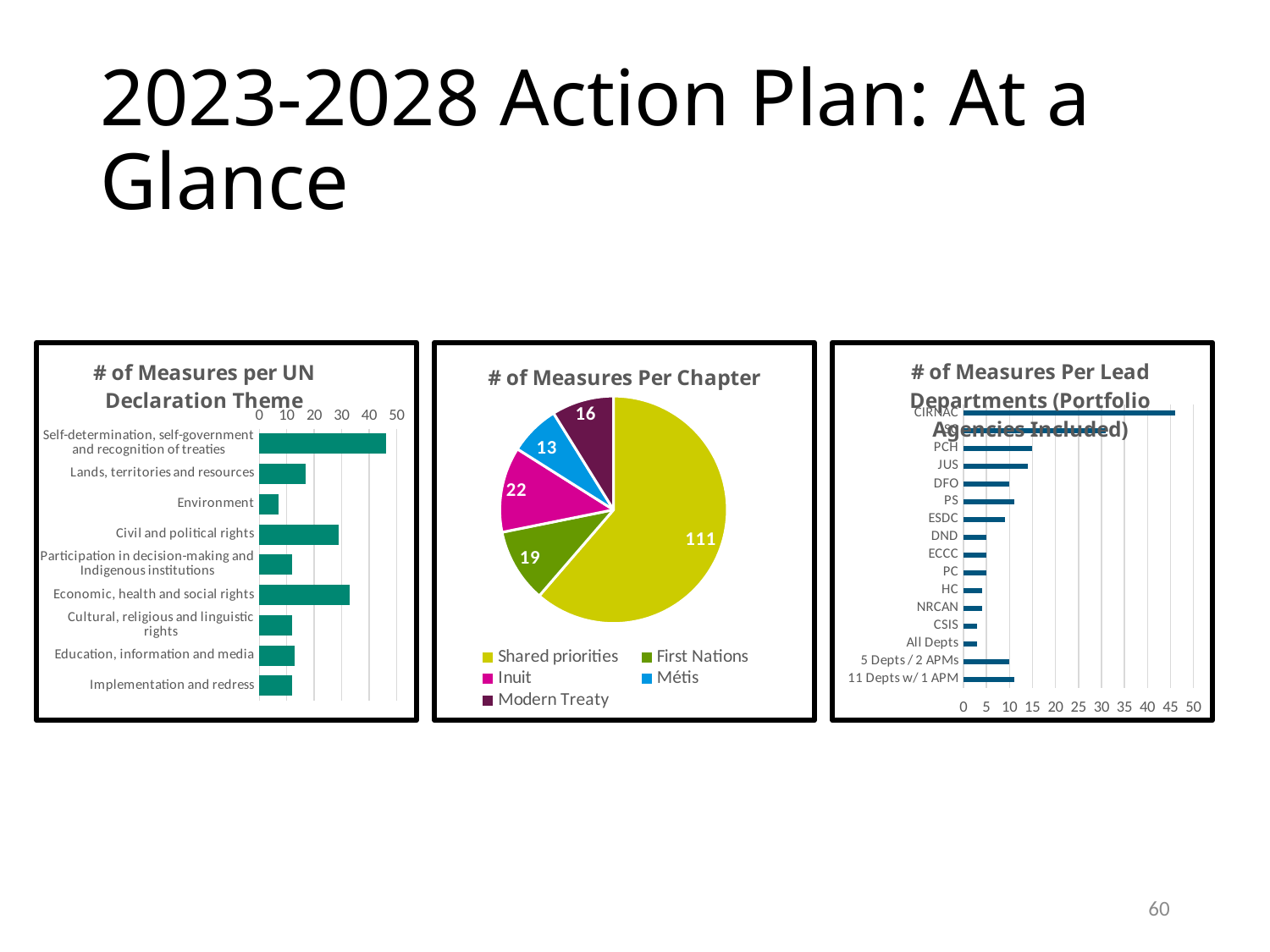
In the '# of Measures Per Chapter' chart, what is the difference between the Inuit and First Nations values? 3 In the '# of Measures Per Lead Departments' chart, which department has the most measures? CIRNAC What kind of chart is the '# of Measures Per Lead Departments (Portfolio Agencies Included)' chart? Bar chart In the '# of Measures Per Chapter' chart, which is larger, Modern Treaty or Métis? Modern Treaty In the '# of Measures per UN Declaration Theme' chart, which theme has the fewest measures? Environment In the '# of Measures Per Chapter' chart, how many measures are in the Inuit slice? 22 In the '# of Measures per UN Declaration Theme' chart, is the value for Civil and political rights greater or less than 20? greater How many entries does the legend of the '# of Measures Per Chapter' chart list? 5 In the '# of Measures Per Chapter' chart, what is the total number of measures across all slices? 181 In the '# of Measures Per Chapter' chart, how many measures are in the Shared priorities slice? 111 In the '# of Measures Per Chapter' chart, which chapter has the fewest measures? Métis In the '# of Measures per UN Declaration Theme' chart, which theme has the most measures? Self-determination, self-government and recognition of treaties